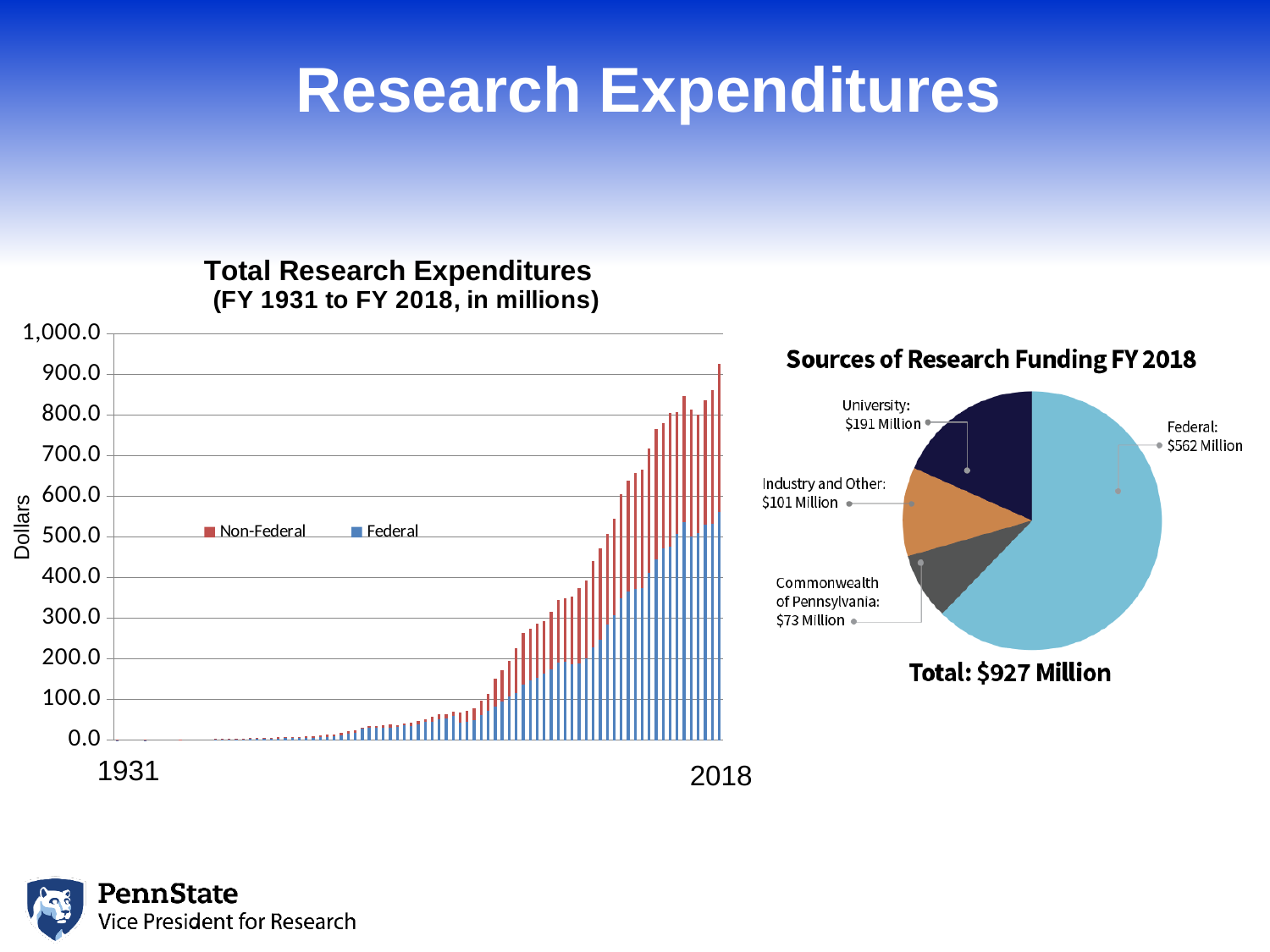
In the Total Research Expenditures chart, how many series does the legend list? 2 In the Sources of Research Funding FY 2018 pie chart, what total is shown below the pie? $927 Million In the Sources of Research Funding FY 2018 pie chart, which is larger, University or Industry and Other? University In the Sources of Research Funding FY 2018 pie chart, which source is the smallest? Commonwealth of Pennsylvania In the Sources of Research Funding FY 2018 pie chart, what is the value for Commonwealth of Pennsylvania? $73 Million In the Sources of Research Funding FY 2018 pie chart, what is the difference between the Federal and University values? $371 Million What kind of chart is the Total Research Expenditures chart on the left? Bar chart In the Sources of Research Funding FY 2018 pie chart, what is the value for Industry and Other? $101 Million In the Sources of Research Funding FY 2018 pie chart, which source is the largest? Federal In the Sources of Research Funding FY 2018 pie chart, what is the value for Federal? $562 Million In the Total Research Expenditures chart, do the values rise or fall from 1931 to 2018? Rise In the Sources of Research Funding FY 2018 pie chart, how many slices are there? 4